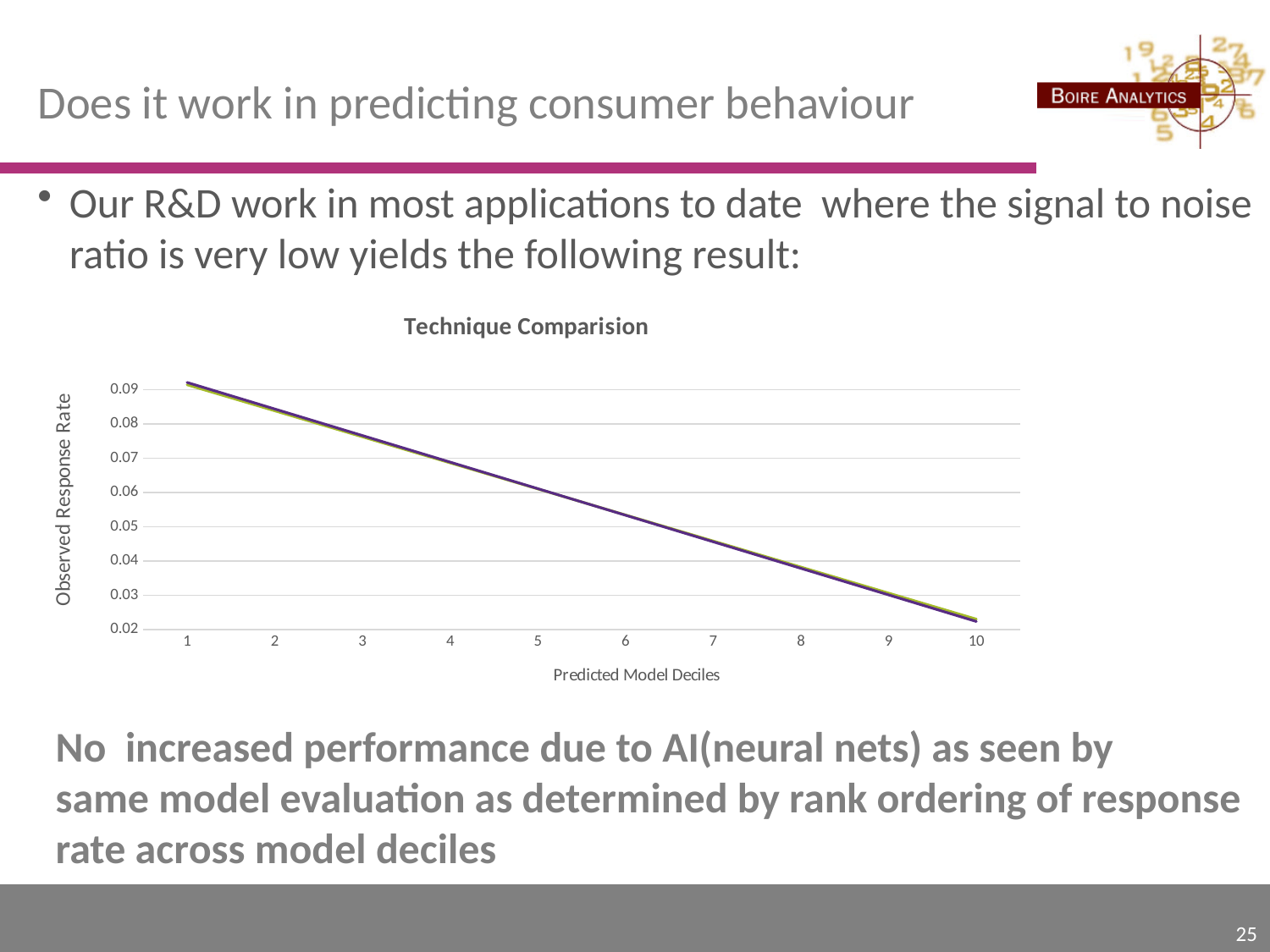
What is the title of the chart? Technique Comparision What is the label of the x axis of the chart? Predicted Model Deciles Do the observed response rate values rise or fall as the predicted model decile increases from 1 to 10? fall Which has a higher observed response rate, decile 2 or decile 9? decile 2 What kind of chart is shown on the slide? line chart Is the observed response rate for decile 8 greater or less than 0.05? less Which decile has the lowest observed response rate? 10 Is the observed response rate for decile 5 greater or less than 0.05? greater Is the observed response rate for decile 1 greater or less than 0.08? greater Which decile has the highest observed response rate? 1 How many deciles are plotted along the x axis? 10